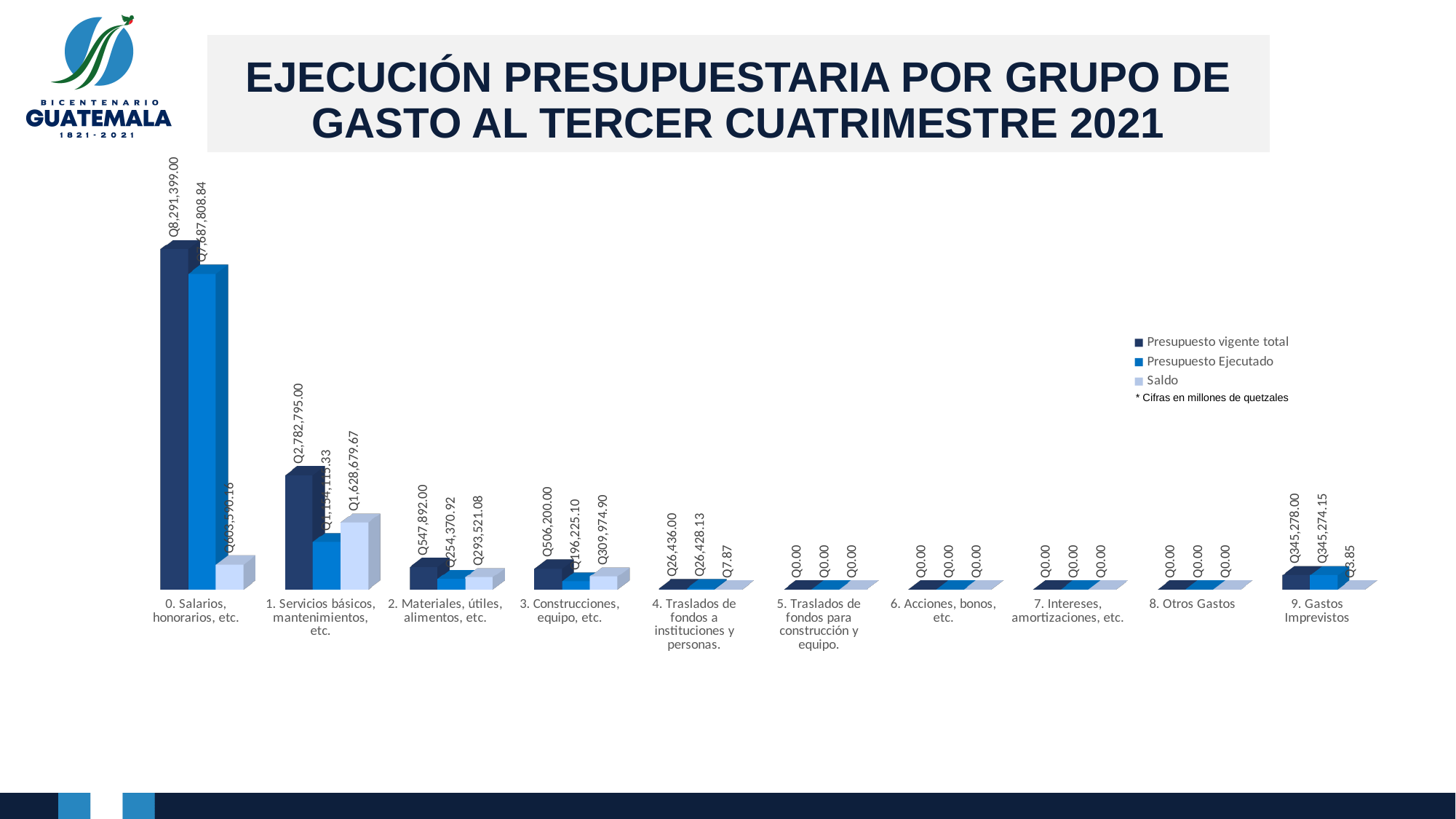
What is the difference between the Presupuesto vigente total and the Presupuesto Ejecutado for '4. Traslados de fondos a instituciones y personas.'? Q7.87 What is the Saldo for '9. Gastos Imprevistos'? Q3.85 What is the Saldo for '3. Construcciones, equipo, etc.'? Q309,974.90 What is the Presupuesto vigente total for '0. Salarios, honorarios, etc.'? Q8,291,399.00 Which category has the highest Presupuesto vigente total? 0. Salarios, honorarios, etc. Which is larger for '3. Construcciones, equipo, etc.': the Presupuesto Ejecutado or the Saldo? Saldo How many expense group categories are shown on the x axis? 10 What kind of chart is shown on the slide? Bar chart What is the Presupuesto Ejecutado for '2. Materiales, útiles, alimentos, etc.'? Q254,370.92 What is the Presupuesto vigente total for '1. Servicios básicos, mantenimientos, etc.'? Q2,782,795.00 How many series does the legend list? 3 Which category has the largest Saldo? 1. Servicios básicos, mantenimientos, etc.